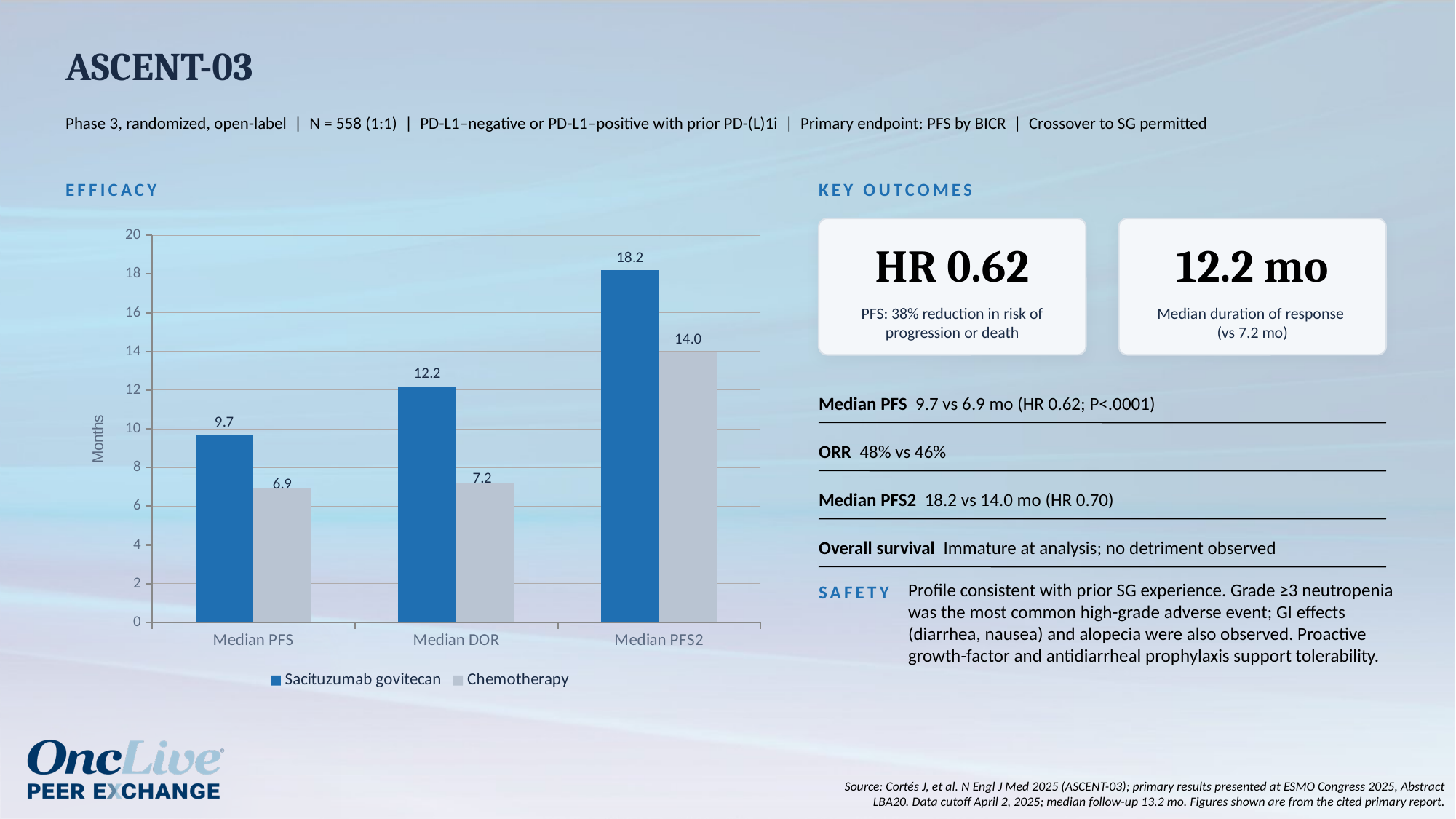
How many series does the chart legend list? 2 Which category has the highest value for Chemotherapy? Median PFS2 What is the Median PFS2 value for Sacituzumab govitecan? 18.2 How many categories are shown on the x axis of the chart? 3 What is the label of the y axis of the chart? Months Which category has the lowest value for Sacituzumab govitecan? Median PFS What is the Median DOR value for Chemotherapy? 7.2 Which is larger for Median PFS: Sacituzumab govitecan or Chemotherapy? Sacituzumab govitecan What is the Median PFS value for Sacituzumab govitecan? 9.7 What is the difference between the Sacituzumab govitecan and Chemotherapy values for Median PFS2? 4.2 What is the difference between the Sacituzumab govitecan and Chemotherapy values for Median DOR? 5.0 What kind of chart is shown on the slide? Bar chart